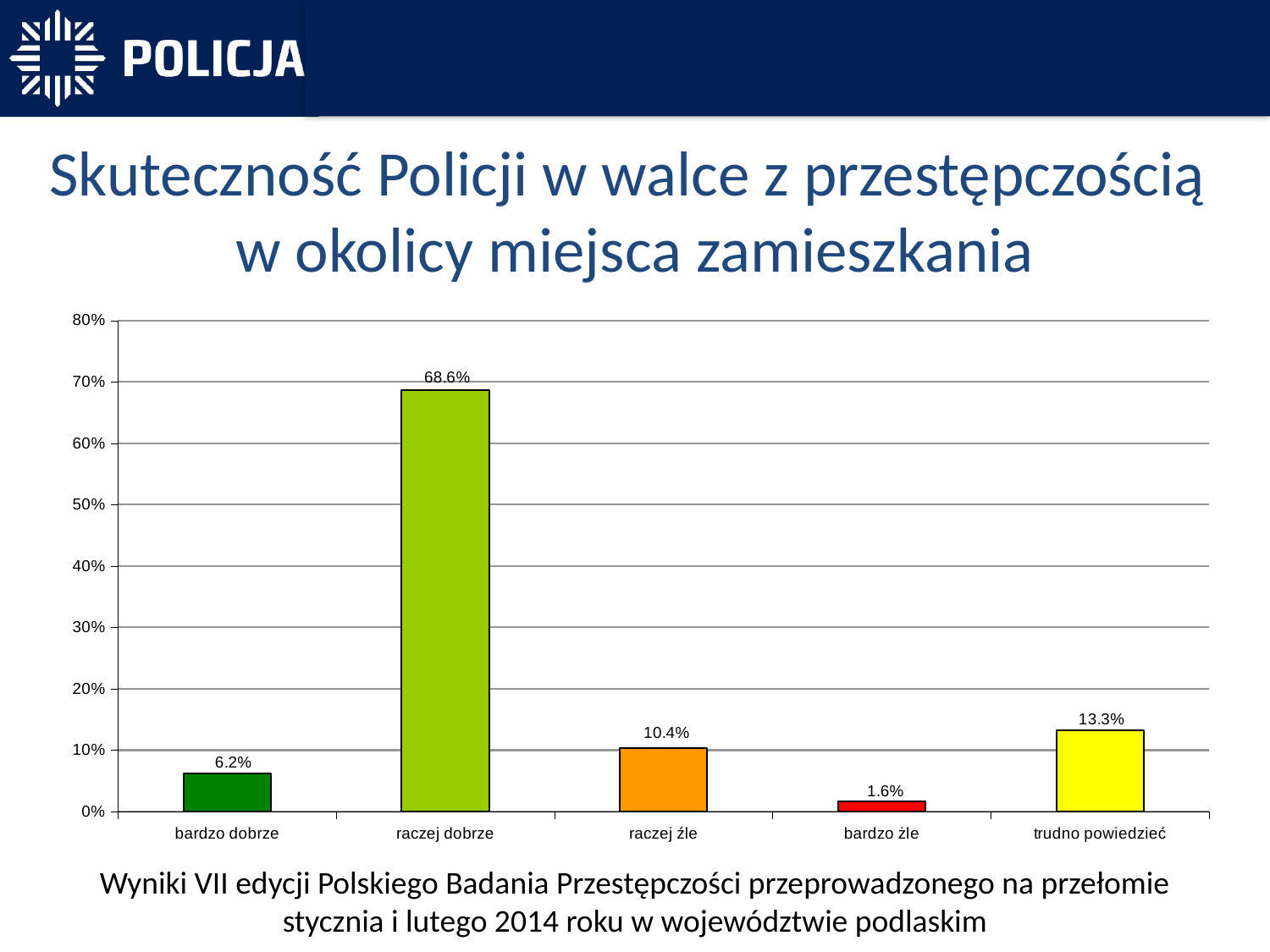
Which category has the lowest value? bardzo źle Which is larger, the value for "raczej źle" or the value for "bardzo dobrze"? raczej źle What is the difference between the values for "trudno powiedzieć" and "raczej źle"? 2.9% What is the value for "raczej dobrze"? 68.6% What colour is the bar for "bardzo źle"? red Which category has the highest value? raczej dobrze What is the value for "bardzo źle"? 1.6% How many categories are shown on the x axis? 5 What is the value for "bardzo dobrze"? 6.2% What is the value for "trudno powiedzieć"? 13.3% What kind of chart is shown on the slide? bar chart Is the value for "raczej dobrze" greater or less than 60%? greater